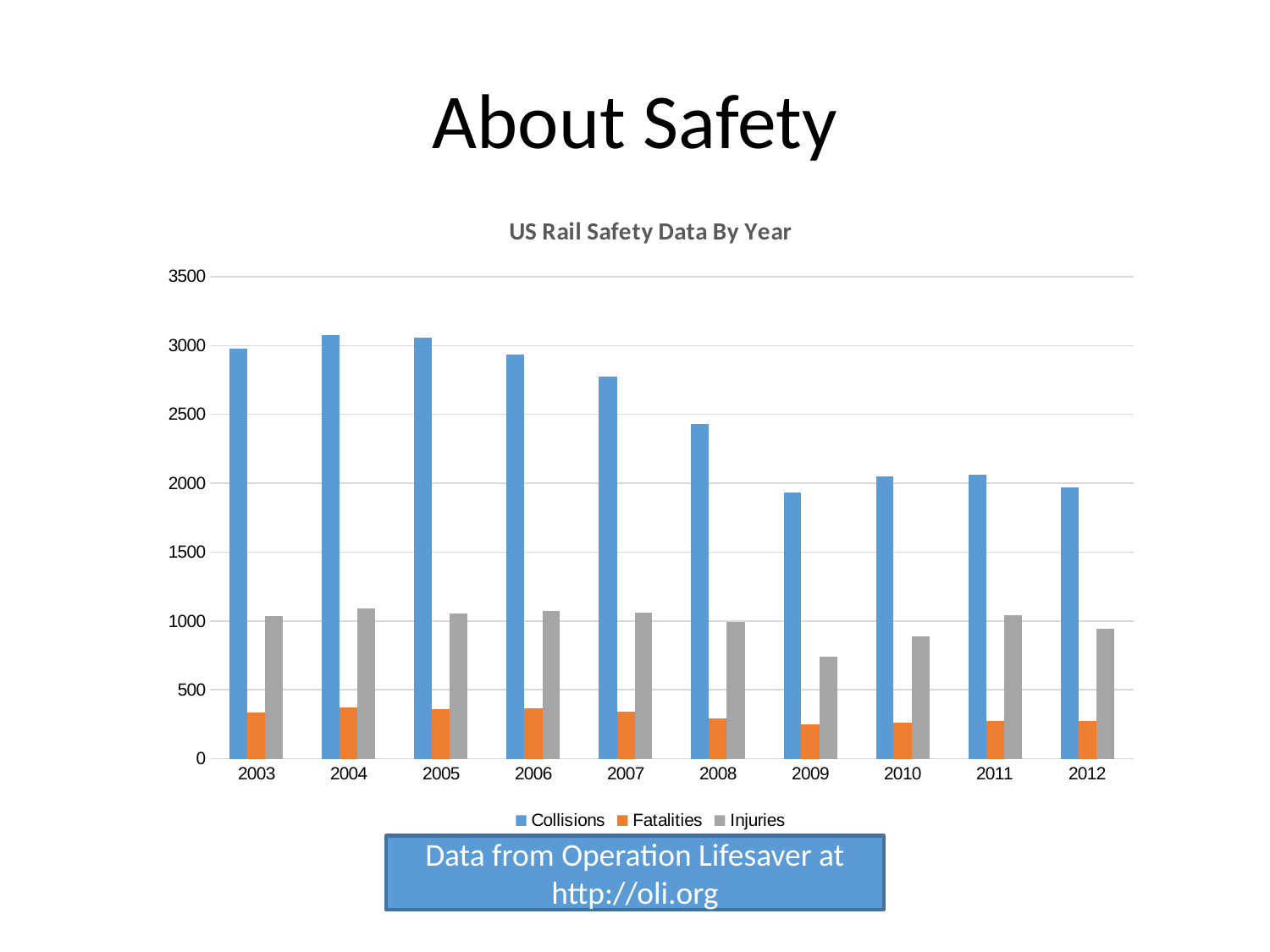
What is the title of the chart? US Rail Safety Data By Year Which colour represents Fatalities in the legend? orange How many years are shown on the x axis? 10 Is the value for Collisions in 2003 greater or less than 2500? greater Is the value for Fatalities in 2003 greater or less than 500? less Which is larger, Collisions in 2003 or Collisions in 2009? 2003 Is the value for Collisions in 2009 greater or less than 2000? less Which year has the lowest value for Injuries? 2009 Do the Collisions values generally rise or fall from 2003 to 2012? fall How many series does the legend list? 3 What kind of chart is shown on the slide? bar chart